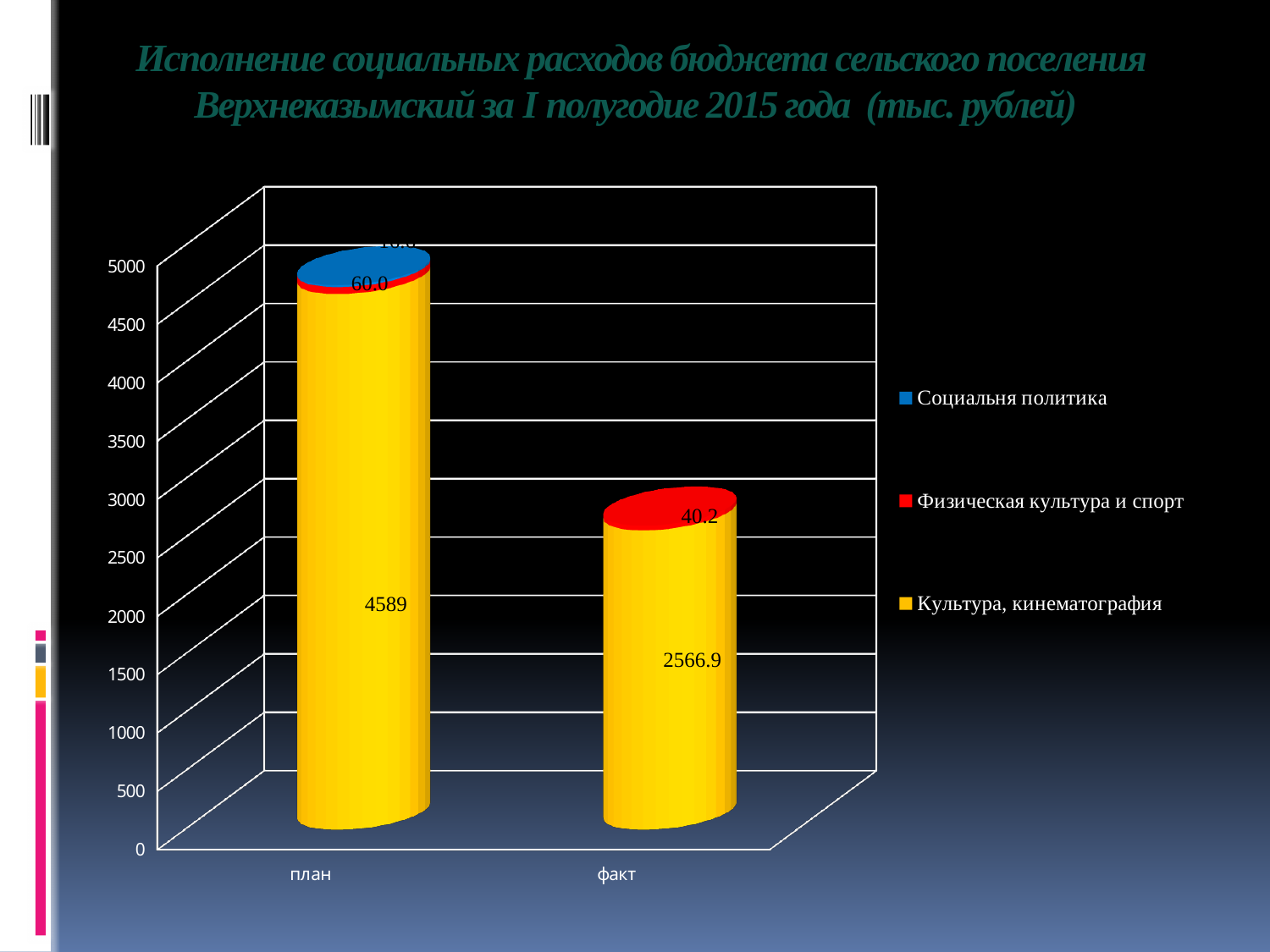
What is the value of Физическая культура и спорт for план? 60.0 Which series is shown in yellow in the legend? Культура, кинематография What is the difference between the Физическая культура и спорт values for план and факт? 19.8 What is the value of Физическая культура и спорт for факт? 40.2 How many series does the legend list? 3 How many categories are shown on the x axis? 2 What is the difference between the Культура, кинематография values for план and факт? 2022.1 What kind of chart is shown on the slide? Stacked bar chart Which category has the larger Культура, кинематография value, план or факт? план What is the value of Культура, кинематография for план? 4589 Which category has the lower Физическая культура и спорт value? факт What is the value of Культура, кинематография for факт? 2566.9